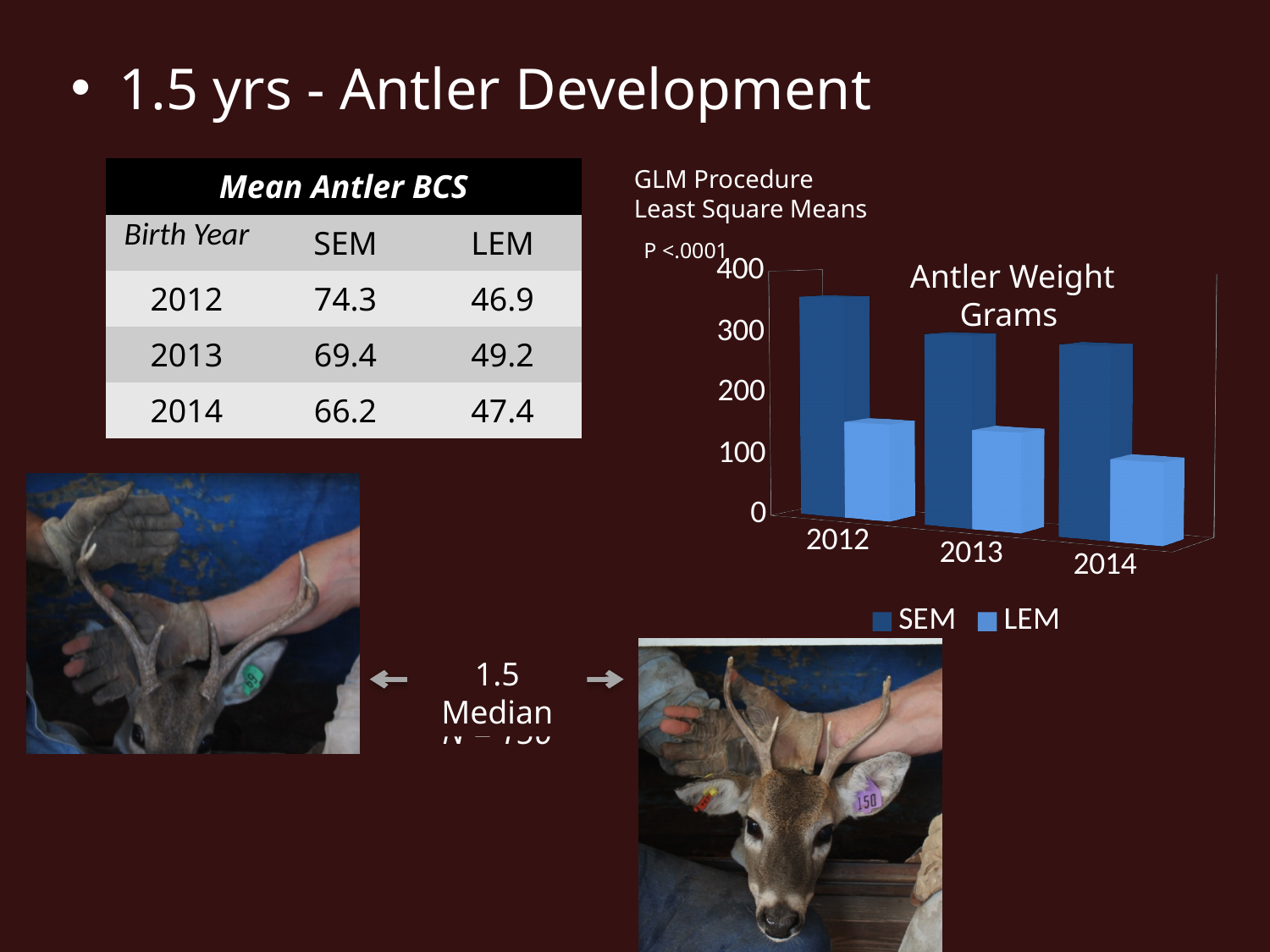
In the Antler Weight Grams chart, which year has the highest SEM value? 2012 What are the two legend entries of the Antler Weight Grams chart? SEM and LEM How many series does the legend of the Antler Weight Grams chart list? 2 In the Antler Weight Grams chart, is the LEM value for 2014 greater or less than 200? less What is the title of the chart on the slide? Antler Weight Grams What type of chart is the Antler Weight Grams chart? bar chart How many birth-year categories are shown on the x axis of the Antler Weight Grams chart? 3 In the Antler Weight Grams chart, is the LEM value for 2012 greater or less than 100? greater In the Antler Weight Grams chart, which year has the lowest LEM value? 2014 In the Antler Weight Grams chart, which is larger for 2013, SEM or LEM? SEM In the Antler Weight Grams chart, is the SEM value for 2012 greater or less than 300? greater In the Antler Weight Grams chart, do the SEM values rise or fall from 2012 to 2014? fall